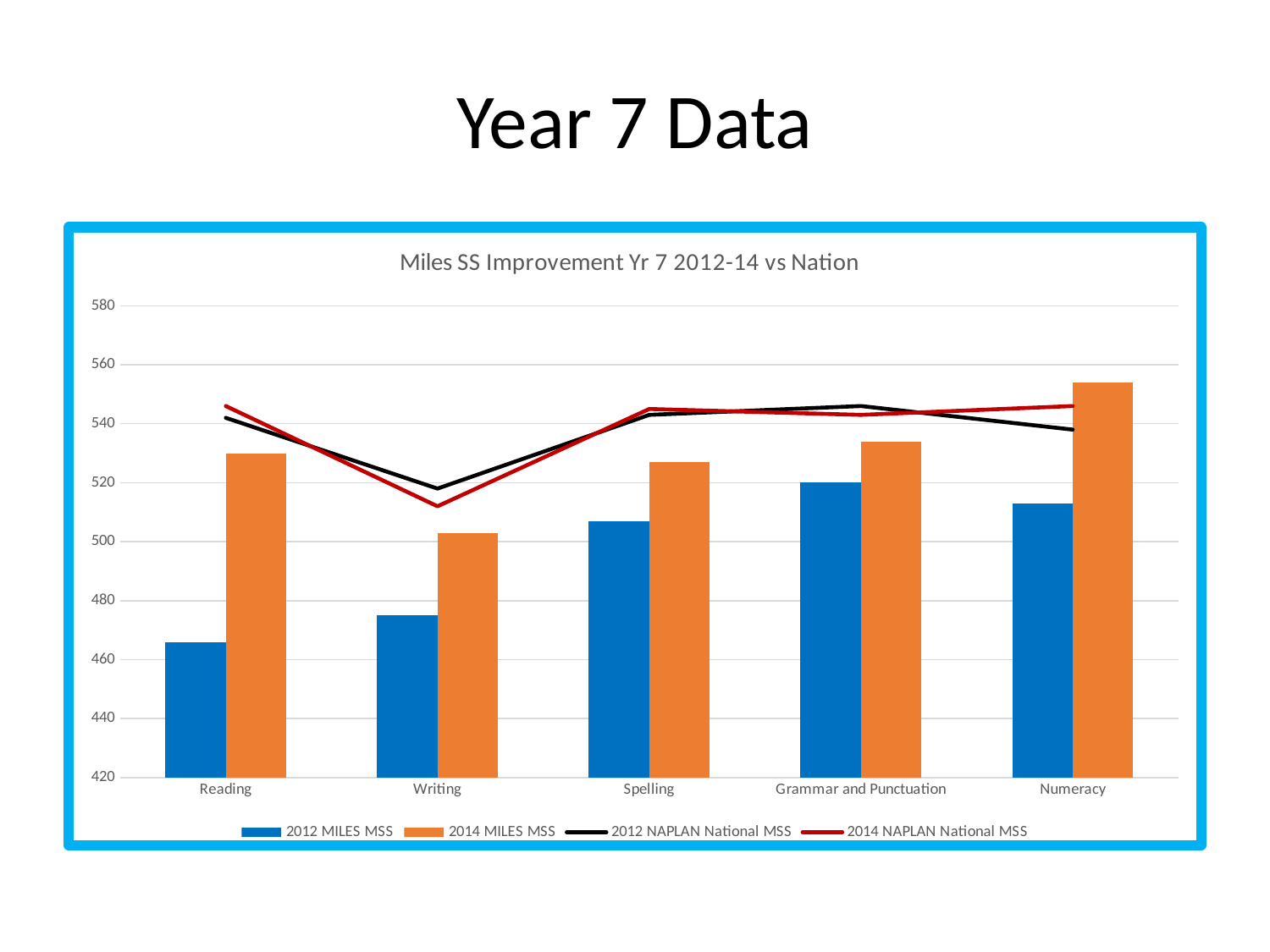
How many categories are shown on the x axis? 5 Which category has the highest 2012 MILES MSS value? Grammar and Punctuation How many series does the legend list? 4 Is the 2012 MILES MSS value for Reading greater or less than 480? less Which category has the lowest 2014 MILES MSS value? Writing What is the title of the chart? Miles SS Improvement Yr 7 2012-14 vs Nation Is the 2014 MILES MSS value for Numeracy greater or less than 540? greater Which category has the highest 2014 MILES MSS value? Numeracy Which category has the lowest 2012 MILES MSS value? Reading Which is larger, the 2014 MILES MSS value for Grammar and Punctuation or for Spelling? Grammar and Punctuation What kind of chart is shown on the slide? combination bar and line chart Is the 2012 MILES MSS value for Spelling greater or less than 500? greater